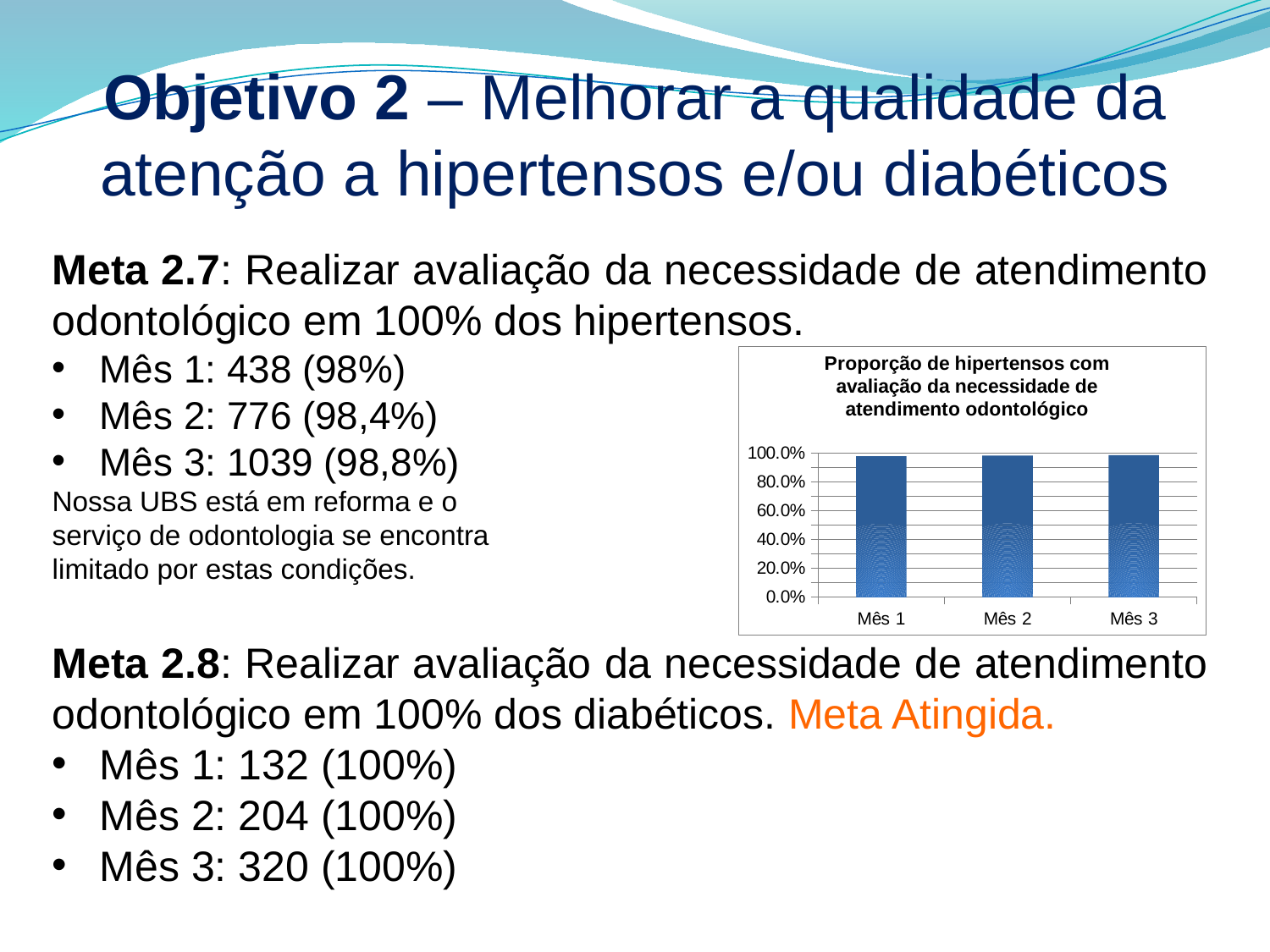
What is the title of the chart? Proporção de hipertensos com avaliação da necessidade de atendimento odontológico What kind of chart is shown on the slide? bar chart What are the category labels on the x axis of the chart? Mês 1, Mês 2, Mês 3 Is the value for Mês 3 in the chart greater or less than 80.0%? greater Is the value for Mês 1 in the chart greater or less than 40.0%? greater Is the value for Mês 1 in the chart greater or less than 80.0%? greater How many bars (categories) does the chart show? 3